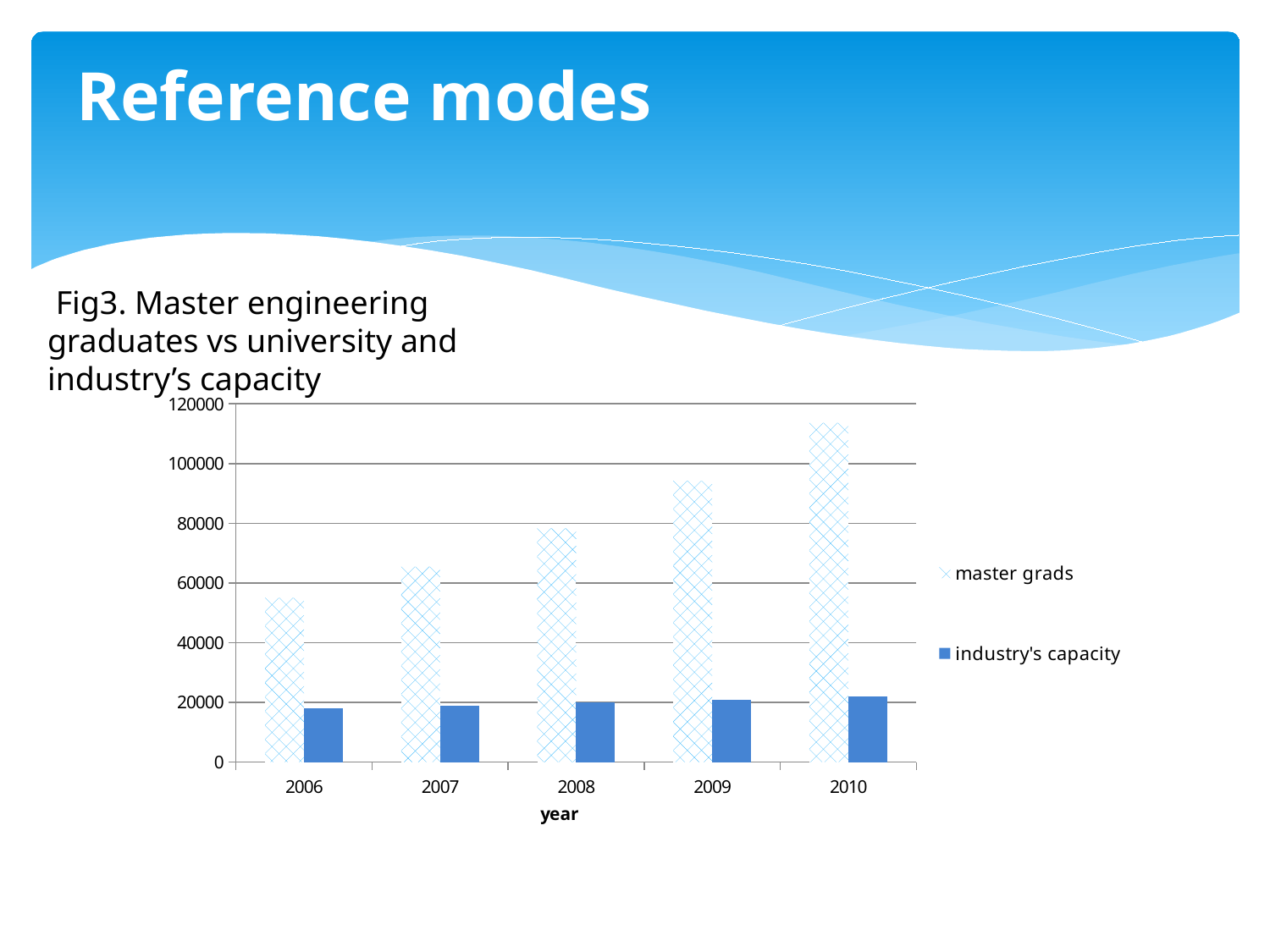
Is the value for master grads in 2010 greater or less than 100000? greater What kind of chart is shown on the slide? bar chart In 2009, which is larger: master grads or industry's capacity? master grads Which year has the lowest value for master grads? 2006 How many series does the chart's legend list? 2 Is the value for industry's capacity in 2008 greater or less than 40000? less How many years are shown on the x axis of the chart? 5 Do the master grads values rise or fall from 2006 to 2010? rise Is the value for master grads in 2006 greater or less than 60000? less Which series is drawn with solid blue bars? industry's capacity What is the title of the x axis of the chart? year Which year has the highest value for master grads? 2010